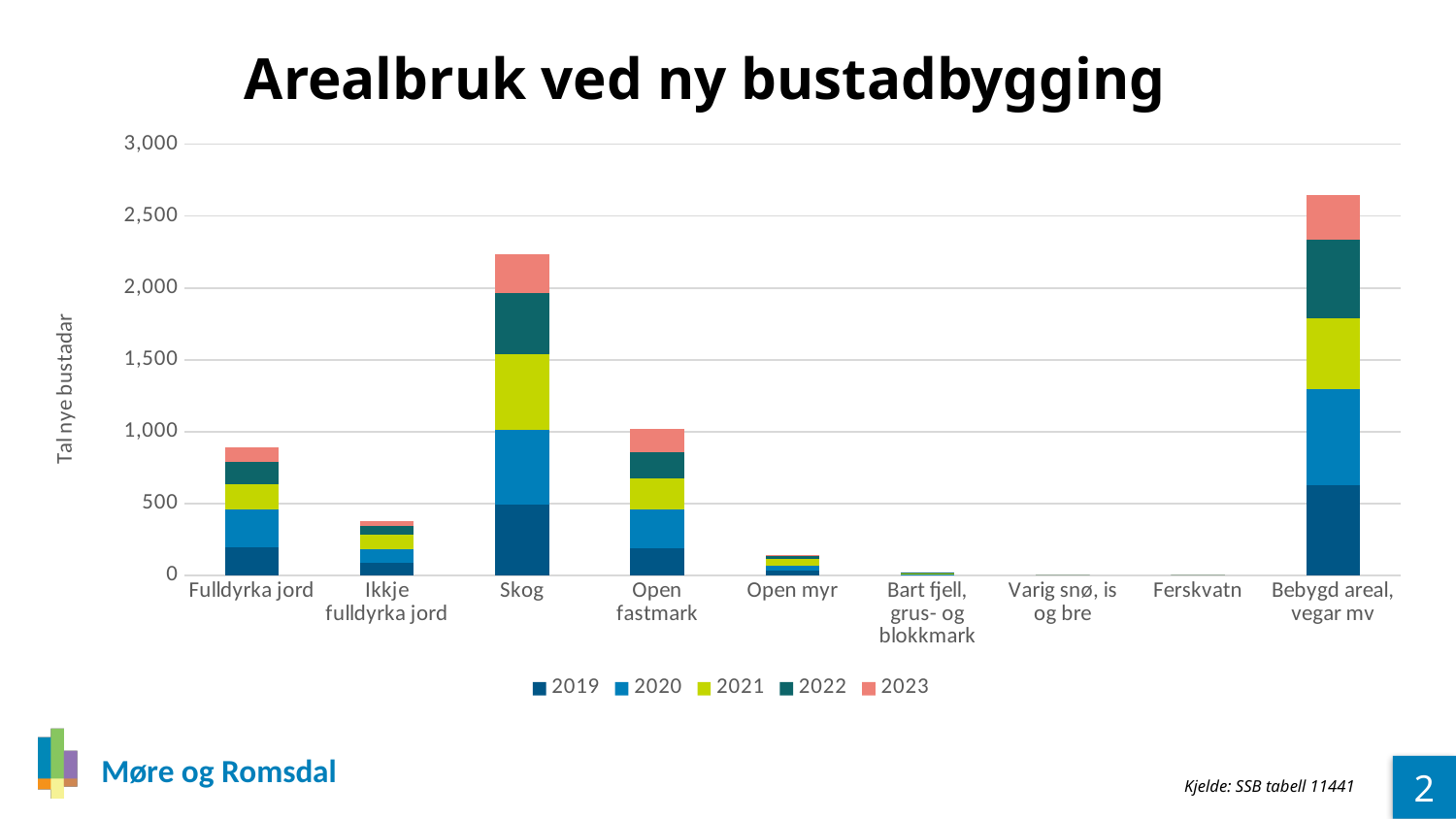
Which category has the highest total number of new dwellings? Bebygd areal, vegar mv How many series does the legend list? 5 Is the total value for Bebygd areal, vegar mv greater or less than 2,500? greater What is the label on the y axis? Tal nye bustadar How many land-use categories are shown on the x axis? 9 What is the title of the chart? Arealbruk ved ny bustadbygging What kind of chart is shown on the slide? Stacked bar chart Is the total value for Ikkje fulldyrka jord greater or less than 500? less Which has a larger total, Fulldyrka jord or Ikkje fulldyrka jord? Fulldyrka jord Which has a larger total, Skog or Open fastmark? Skog Is the total value for Skog greater or less than 2,000? greater